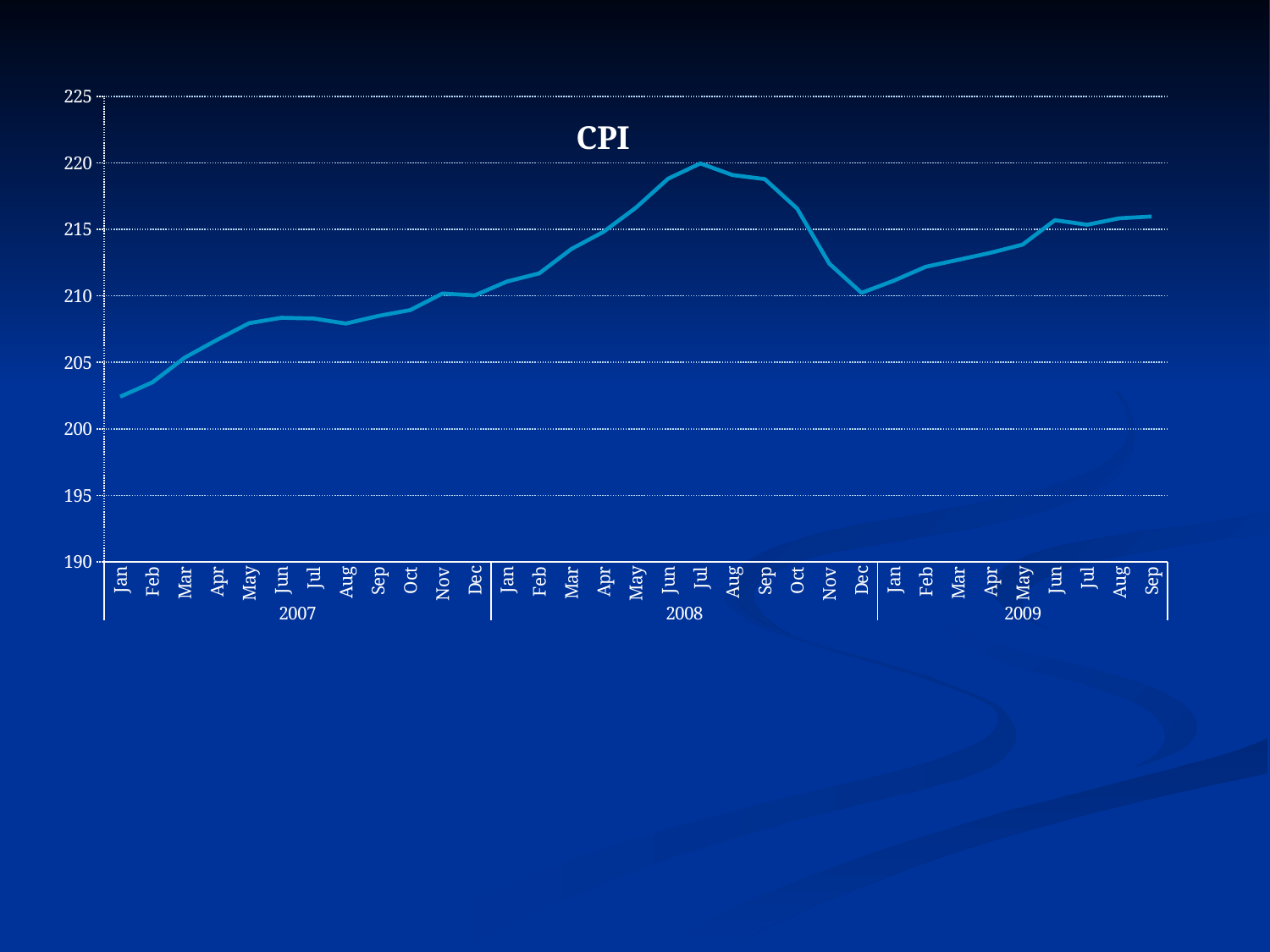
Is the CPI value for Aug 2007 greater or less than 210? less Is the CPI value for Jan 2007 greater or less than 205? less Is the CPI value for Jul 2008 greater or less than 215? greater In which month and year is the CPI line at its lowest point? Jan 2007 How many monthly data points does the line contain? 33 In which month and year does the CPI line reach its highest point? Jul 2008 How many years are labelled on the x axis of the chart? 3 What kind of chart is shown on the slide? line chart Does the CPI line generally rise or fall from Jul 2008 to Dec 2008? fall What is the title of the chart? CPI Which is larger, the CPI value for Jul 2008 or for Dec 2008? Jul 2008